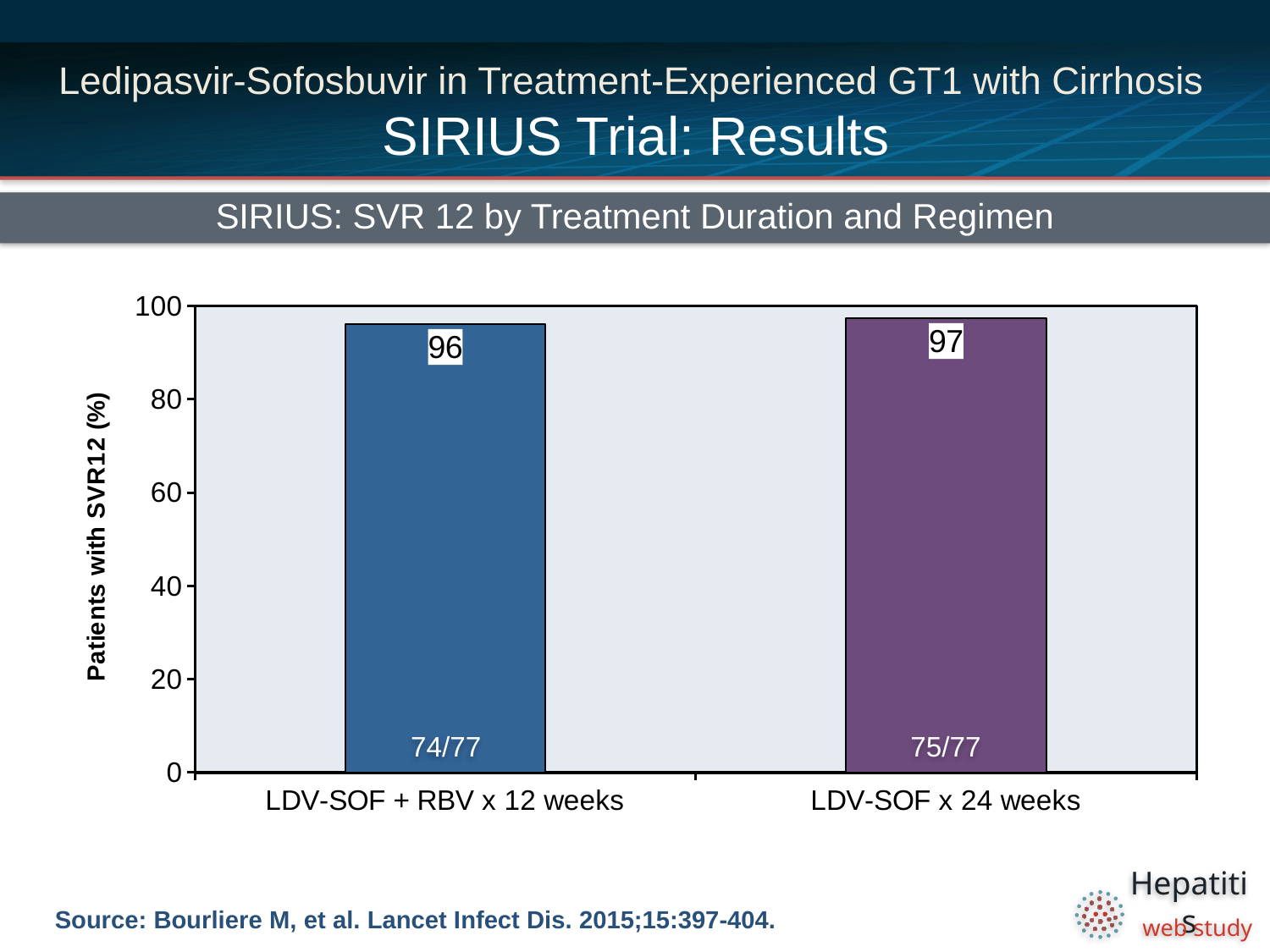
What fraction of patients is shown inside the LDV-SOF x 24 weeks bar? 75/77 Which regimen has the lower SVR12 rate? LDV-SOF + RBV x 12 weeks What is the title of the chart? SIRIUS: SVR 12 by Treatment Duration and Regimen Is the SVR12 rate for LDV-SOF + RBV x 12 weeks greater or less than 80? greater What is the SVR12 rate for LDV-SOF + RBV x 12 weeks? 96 How many treatment regimens are shown on the x axis? 2 What is the difference in SVR12 rate between LDV-SOF x 24 weeks and LDV-SOF + RBV x 12 weeks? 1 What is the SVR12 rate for LDV-SOF x 24 weeks? 97 What fraction of patients is shown inside the LDV-SOF + RBV x 12 weeks bar? 74/77 What is the label of the y axis? Patients with SVR12 (%) What kind of chart is shown on the slide? bar chart Which regimen has the higher SVR12 rate? LDV-SOF x 24 weeks